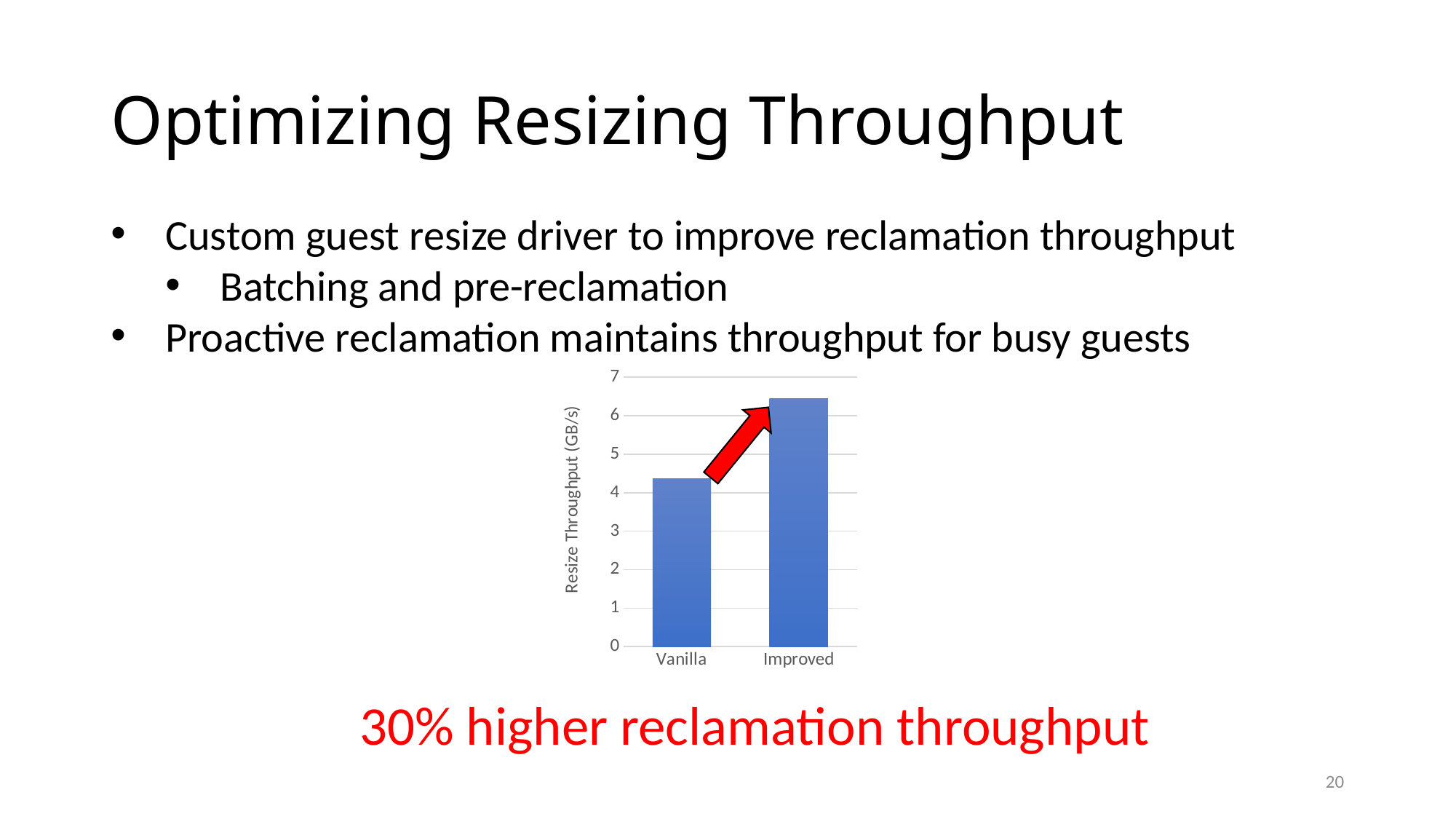
Which category has the lowest resize throughput? Vanilla Is the value for Vanilla greater or less than 5? less Do the values rise or fall from Vanilla to Improved along the x axis? rise What is the label of the chart's y axis? Resize Throughput (GB/s) What is the highest tick value shown on the chart's y axis? 7 Is the value for Improved greater or less than 7? less Which category has the highest resize throughput? Improved Is the value for Improved greater or less than 6? greater What kind of chart is shown on the slide? bar chart How many categories are plotted on the x axis of the chart? 2 Which is larger, the value for Vanilla or the value for Improved? Improved